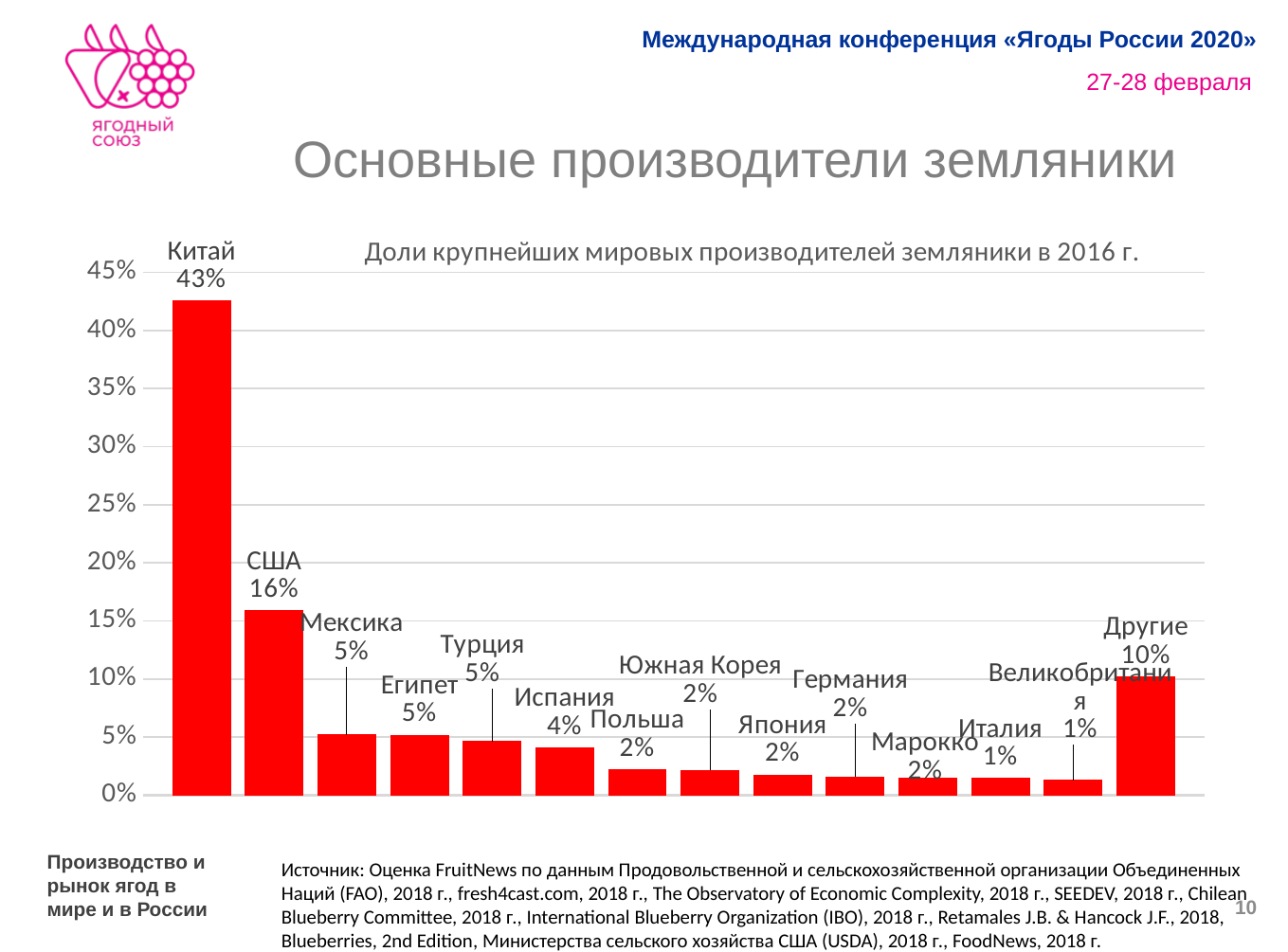
What is the value shown for США? 16% What is the difference in percentage points between the shares of Китай and США? 27 Is the value for Китай greater or less than 40%? greater Which has a larger share, Мексика or Испания? Мексика Which country has the highest share in the chart? Китай What share is shown for Испания? 4% What is the value labelled for Другие? 10% What type of chart is shown on the slide? Bar chart How many bars are plotted in the chart? 14 What is the title of the chart? Доли крупнейших мировых производителей земляники в 2016 г. What colour are the bars in the chart? Red What share of world strawberry production does Китай have according to the chart? 43%